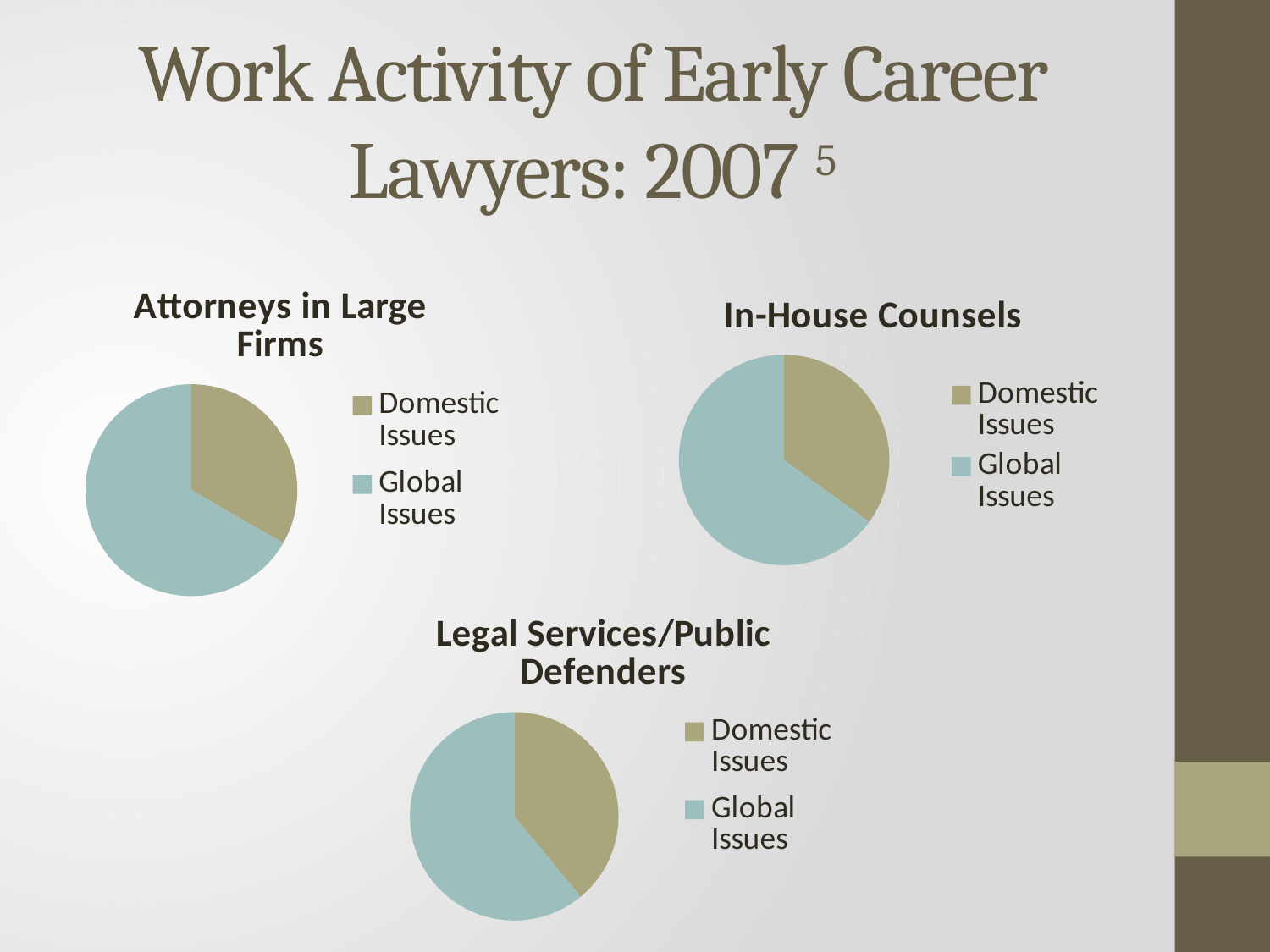
In the "Legal Services/Public Defenders" chart, which slice is larger, Domestic Issues or Global Issues? Global Issues What is the title of the pie chart at the bottom of the slide? Legal Services/Public Defenders How many categories does the legend of the "In-House Counsels" chart list? 2 How many slices does the "Legal Services/Public Defenders" pie chart have? 2 In the "In-House Counsels" chart, is the Domestic Issues slice larger or smaller than the Global Issues slice? Smaller What kind of chart is the "Attorneys in Large Firms" chart? Pie chart How many pie charts are shown on the slide? 3 In the "Attorneys in Large Firms" chart, which colour represents Global Issues? Light blue-green In the "Legal Services/Public Defenders" chart, which category has the smallest share? Domestic Issues In the "Attorneys in Large Firms" chart, which slice is larger, Domestic Issues or Global Issues? Global Issues In the "In-House Counsels" chart, which category has the largest share? Global Issues